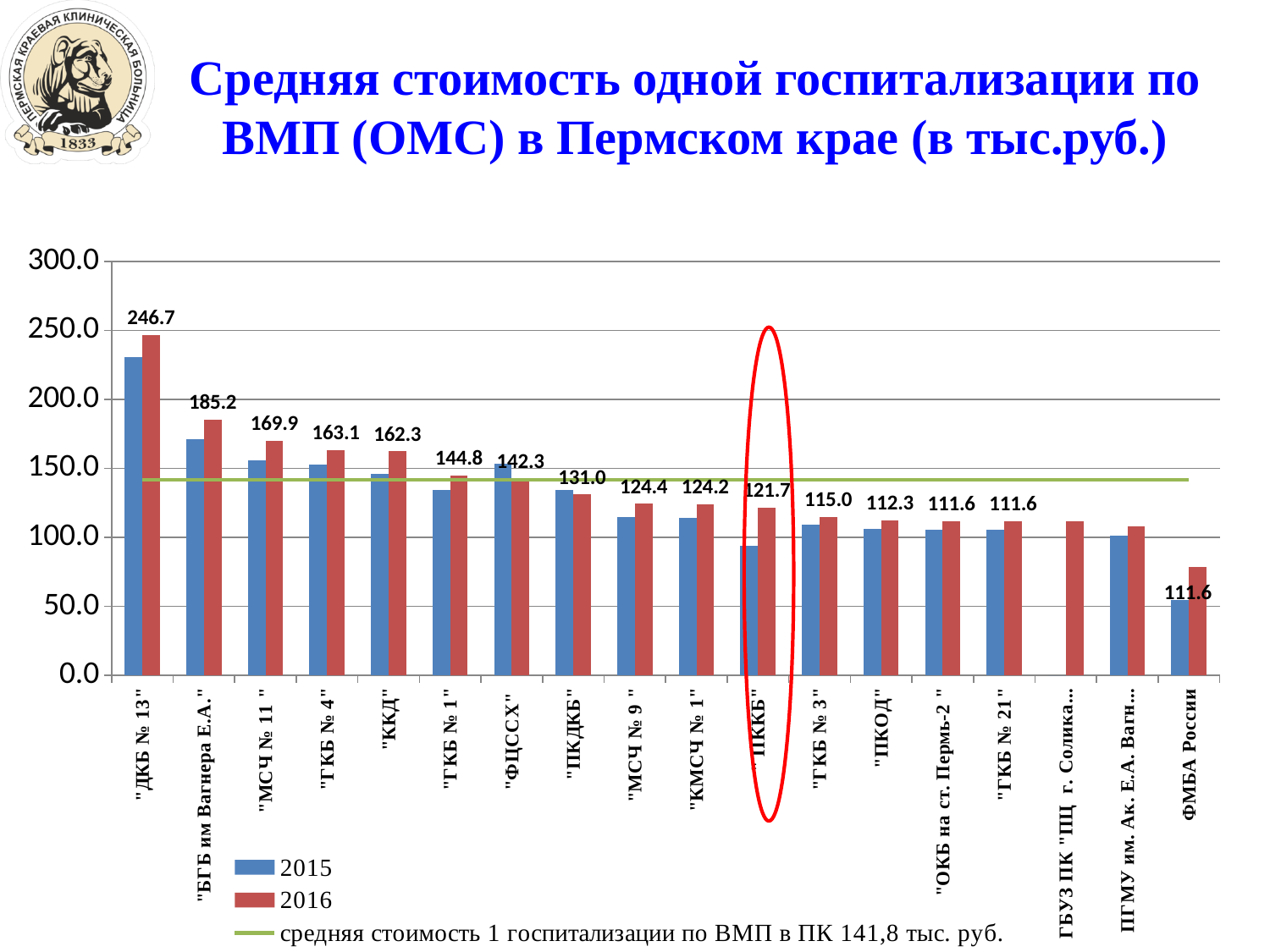
According to the legend, what is the average cost of one hospitalization shown by the green line? 141,8 тыс. руб. Is the 2015 value for "ДКБ № 13" greater or less than 200.0? greater Is the 2015 value for "ФМБА России" greater or less than 100.0? less Which hospital has the highest 2016 value? "ДКБ № 13" What kind of chart is shown on the slide? combination bar and line chart What is the 2016 value for "БГБ им Вагнера Е.А."? 185.2 What is the 2016 value for "ДКБ № 13"? 246.7 What is the 2016 value for "ПККБ"? 121.7 How many entries does the chart legend list? 3 How many hospitals (categories) are shown on the x axis? 18 What is the difference between the 2016 values for "ДКБ № 13" and "БГБ им Вагнера Е.А."? 61.5 Which has the larger 2016 value, "МСЧ № 11" or "ГКБ №4"? "МСЧ № 11"